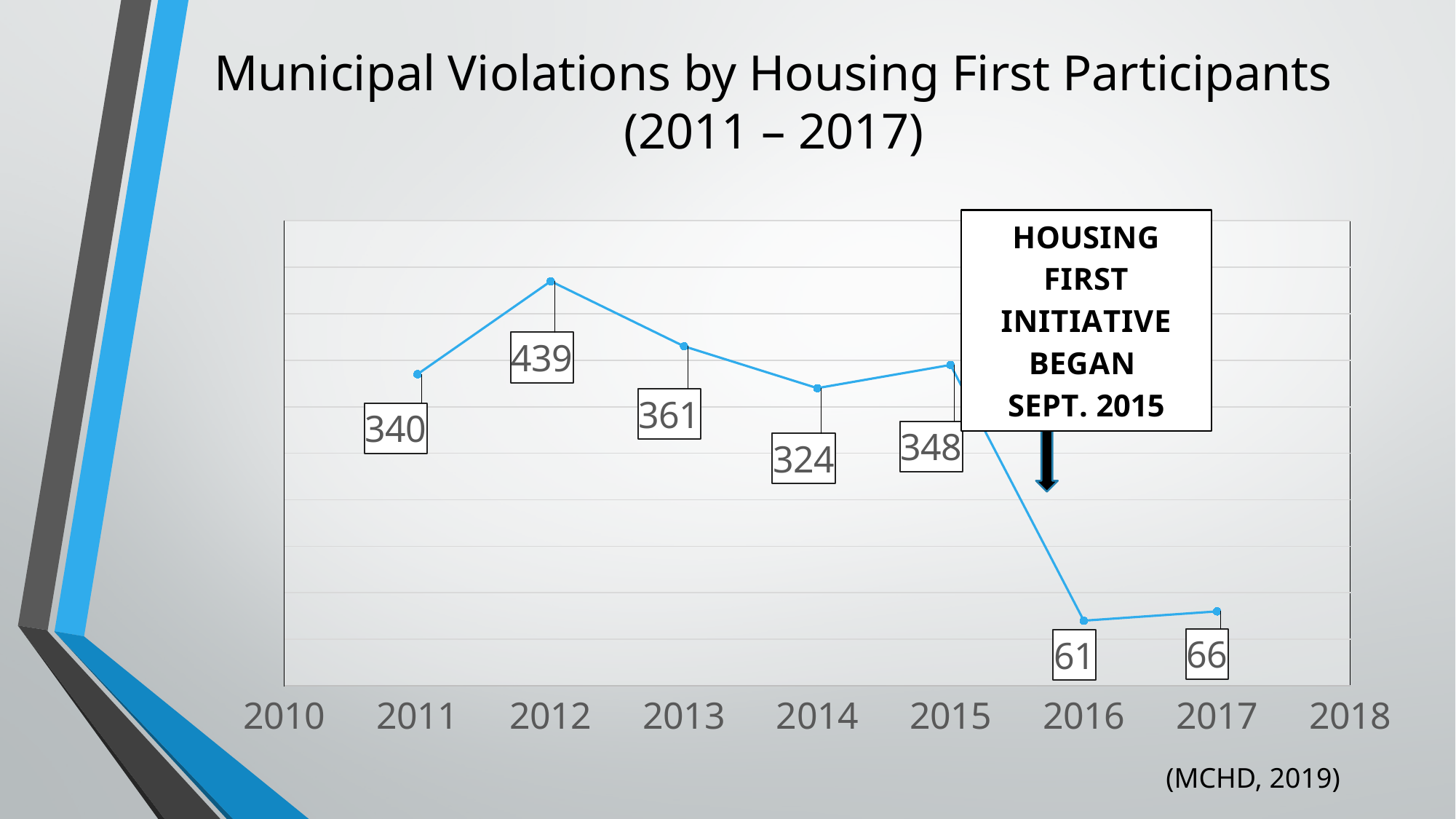
What type of chart is shown on the slide? Line chart What was the number of municipal violations in 2012? 439 What was the number of municipal violations in 2016? 61 What is the difference between the violations in 2015 and 2016? 287 What was the number of municipal violations in 2014? 324 Which year had the lowest number of municipal violations? 2016 Which year had more municipal violations, 2016 or 2017? 2017 Which year had the highest number of municipal violations? 2012 How many years have data points plotted on the chart? 7 Which year had more municipal violations, 2013 or 2014? 2013 What is the difference between the violations in 2012 and 2011? 99 According to the annotation on the chart, when did the Housing First Initiative begin? Sept. 2015